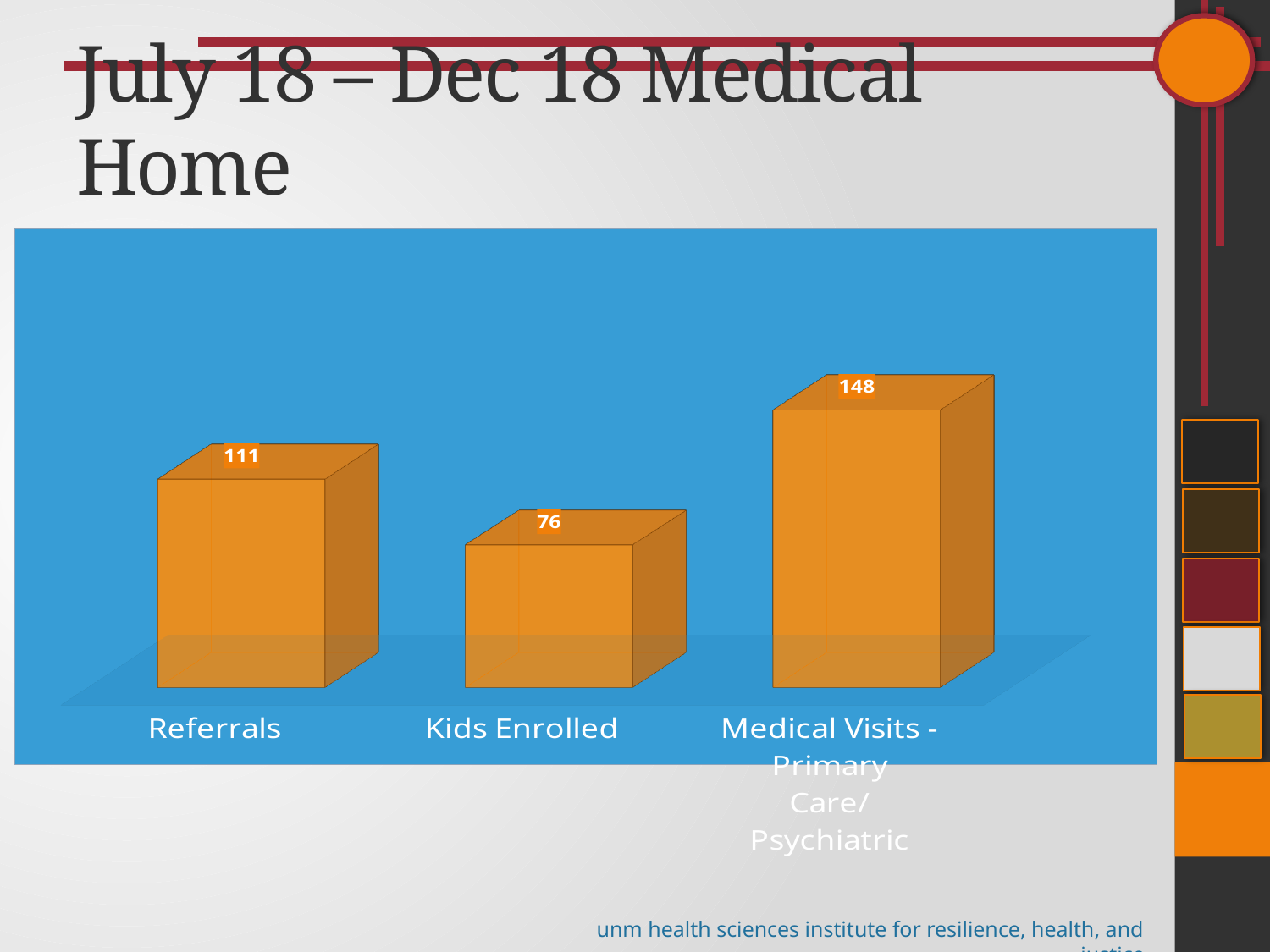
Which category has the lowest value? Kids Enrolled Which category has the highest value? Medical Visits - Primary Care/Psychiatric Which is larger, Referrals or Kids Enrolled? Referrals What kind of chart is shown on the slide? Bar chart What is the difference between Medical Visits - Primary Care/Psychiatric and Referrals? 37 What is the value for Medical Visits - Primary Care/Psychiatric? 148 How many categories are shown in the chart? 3 What is the difference between Referrals and Kids Enrolled? 35 What is the title of the slide containing the chart? July 18 – Dec 18 Medical Home What is the value for Kids Enrolled? 76 What colour are the bars in the chart? Orange What is the value for Referrals? 111